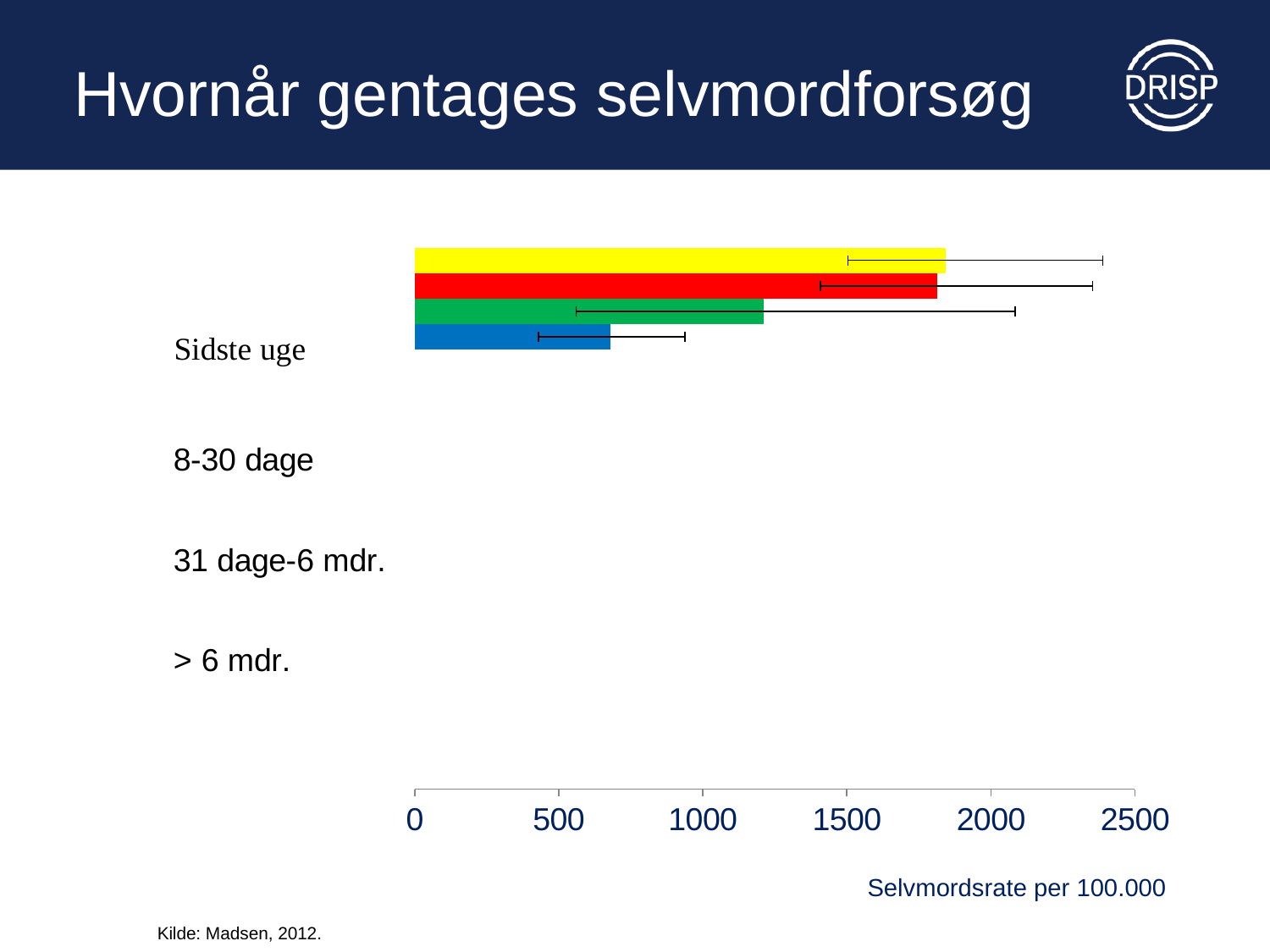
What is the label of the horizontal axis of the chart? Selvmordsrate per 100.000 Is the value of the green bar greater or less than 1000? greater Is the value of the blue bar greater or less than 500? greater Is the value of the red bar greater or less than 2000? less What kind of chart is shown on the slide? bar chart Which is larger, the value of the green bar or the value of the blue bar? the green bar What is the highest tick value shown on the horizontal axis? 2500 Which bar is the shortest in the chart? the blue bar How many bars are plotted in the chart? 4